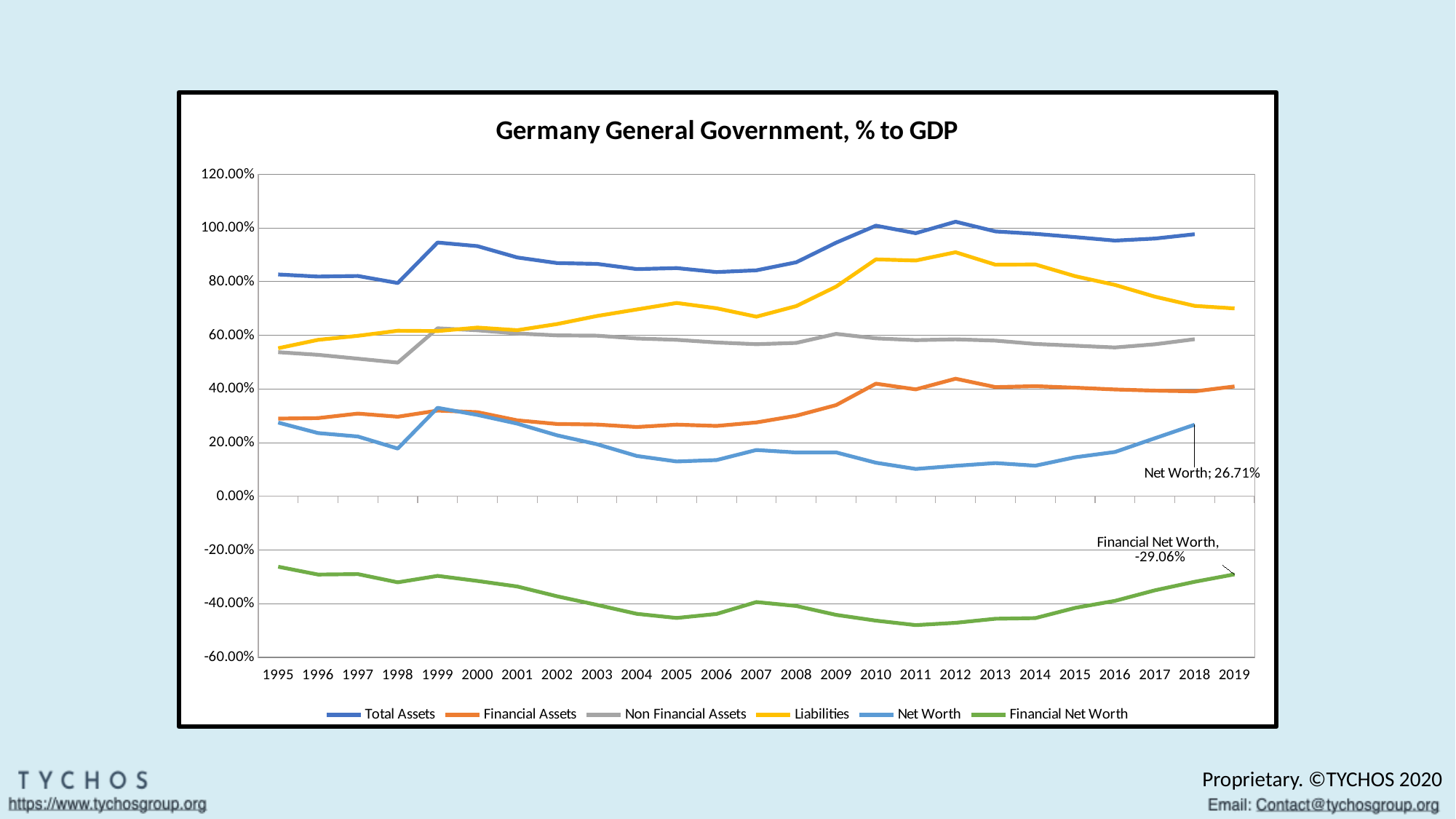
Which series has the highest value in 2019? Liabilities What is the labelled value for Net Worth at the end of its line? 26.71% How many series does the legend list? 6 What type of chart is shown on the slide? line chart Which series has the lowest value in 2019? Financial Net Worth Is the value for Liabilities in 2012 greater or less than 80.00%? greater How many years are shown on the x axis? 25 What is the title of the chart? Germany General Government, % to GDP In 2012, which is larger: Liabilities or Non Financial Assets? Liabilities Does the Liabilities line rise or fall from 2012 to 2019? fall Is the value for Financial Net Worth in 2011 greater or less than -40.00%? less What is the labelled value for Financial Net Worth in 2019? -29.06%